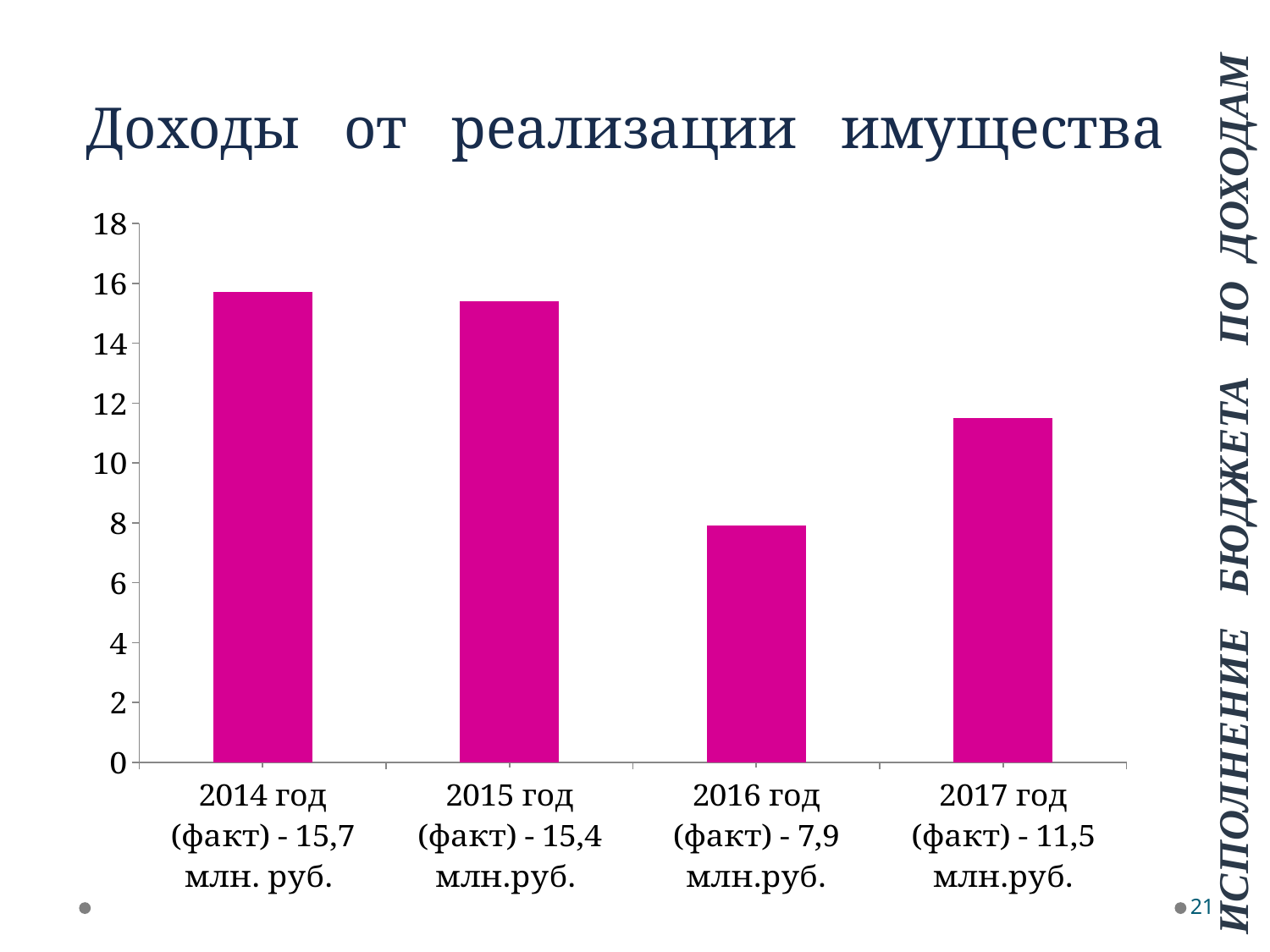
What is the value for 2016 год? 7,9 млн.руб. Which year has the lowest value? 2016 год Which year has the highest value? 2014 год What is the title of the chart? Доходы от реализации имущества What is the value for 2017 год? 11,5 млн.руб. How many years are shown on the chart? 4 Which is larger, the value for 2016 год or the value for 2017 год? 2017 год What kind of chart is shown on the slide? bar chart What is the difference between the values for 2014 год and 2015 год? 0,3 млн. руб. What is the difference between the values for 2017 год and 2016 год? 3,6 млн.руб. Is the value for 2017 год greater or less than 10? greater What is the value for 2014 год? 15,7 млн. руб.